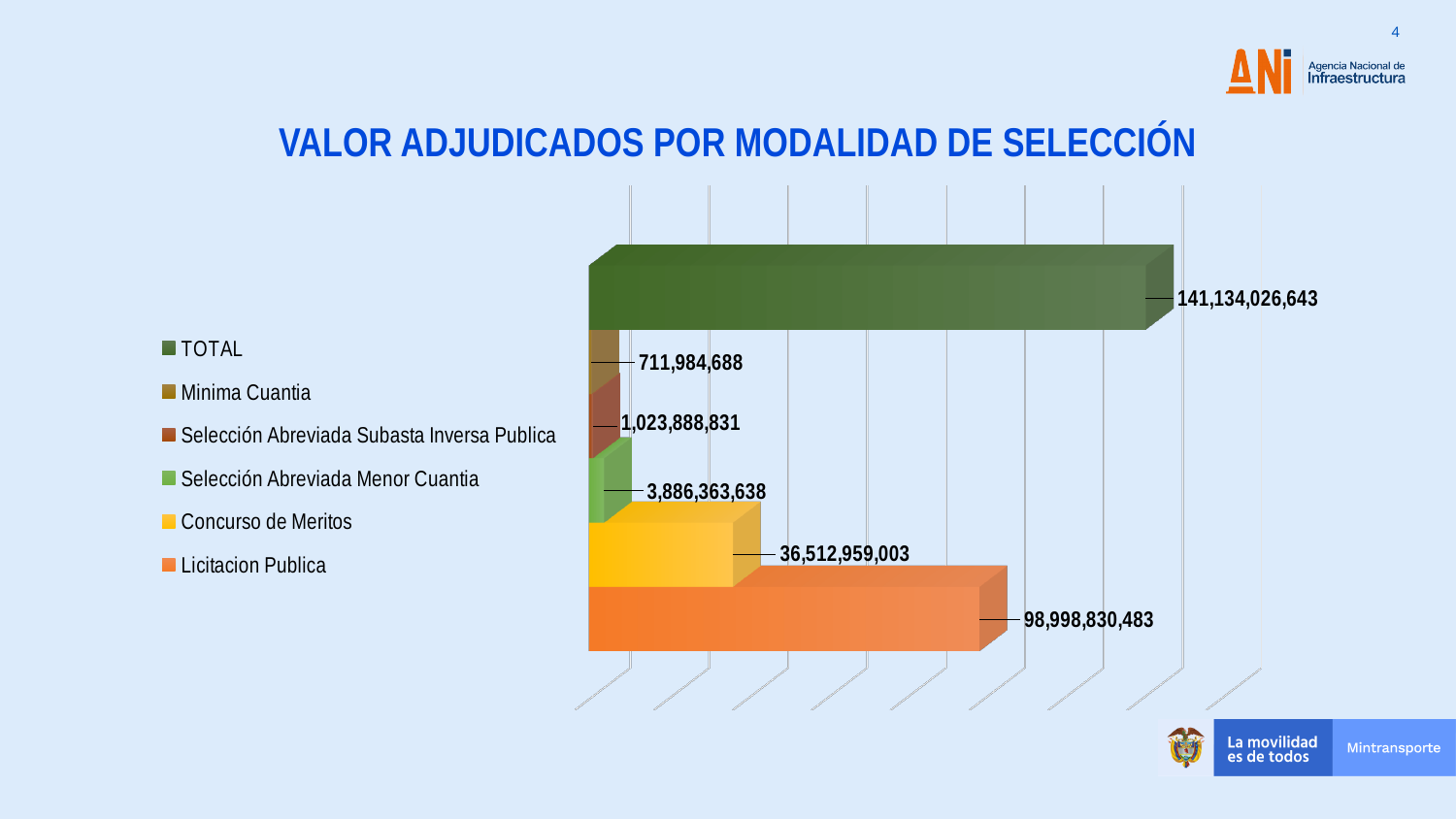
Which selection modality has the lowest adjudicated value? Minima Cuantia Which is larger, the value for Selección Abreviada Menor Cuantia or the value for Selección Abreviada Subasta Inversa Publica? Selección Abreviada Menor Cuantia What is the difference between the values for Licitacion Publica and Concurso de Meritos? 62,485,871,480 What is the value shown for TOTAL? 141,134,026,643 What is the value shown for Minima Cuantia? 711,984,688 How many entries does the legend list? 6 What is the value shown for Selección Abreviada Menor Cuantia? 3,886,363,638 Excluding TOTAL, which selection modality has the highest adjudicated value? Licitacion Publica What is the value shown for Selección Abreviada Subasta Inversa Publica? 1,023,888,831 What is the value shown for Concurso de Meritos? 36,512,959,003 What is the value shown for Licitacion Publica? 98,998,830,483 What type of chart is shown on the slide? Bar chart